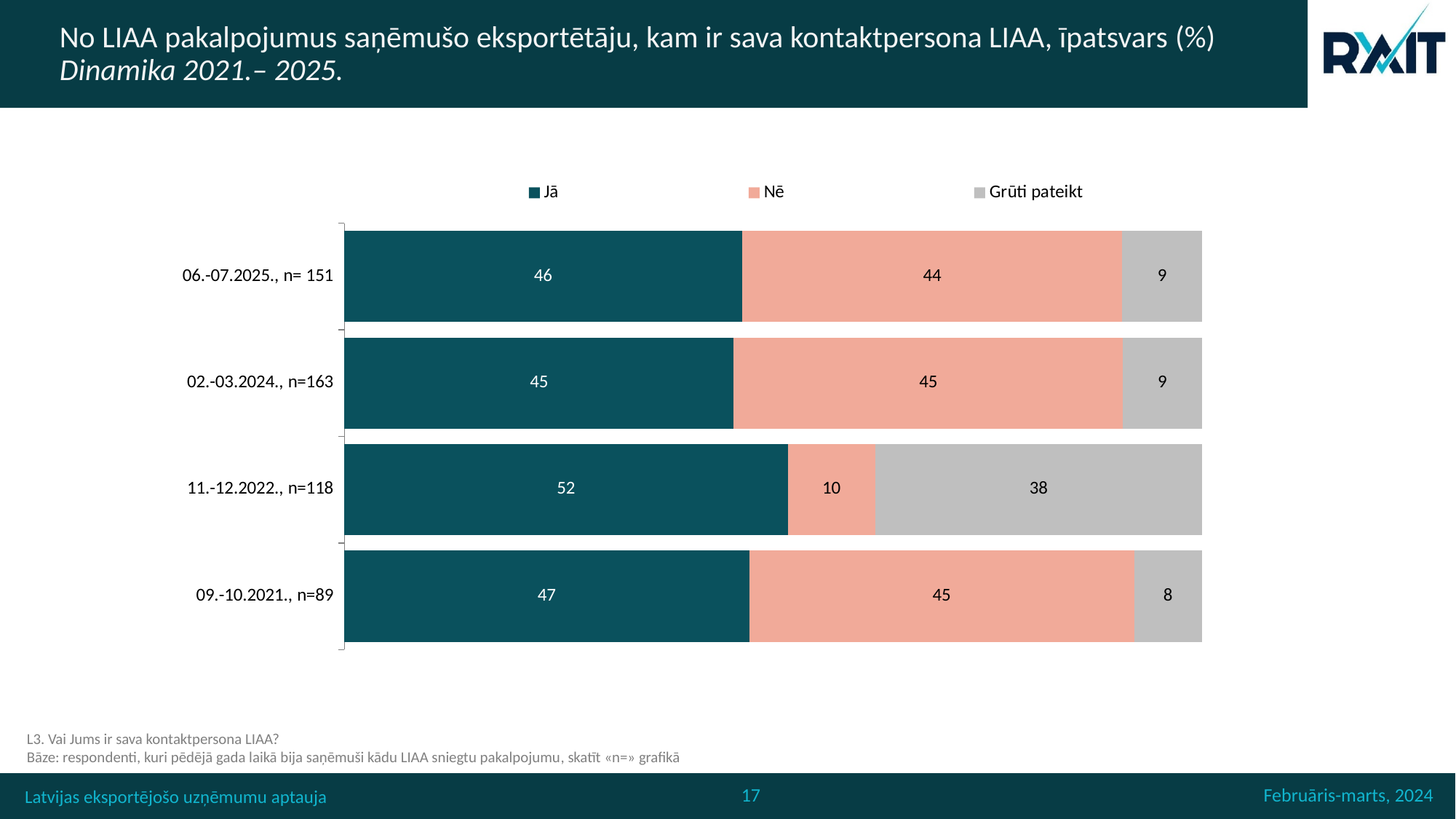
What kind of chart is shown on the slide? Stacked bar chart What is the value for "Nē" in the 11.-12.2022., n=118 bar? 10 What is the value for "Grūti pateikt" in the 09.-10.2021., n=89 bar? 8 Which period has the lowest value for "Nē"? 11.-12.2022., n=118 How many periods (bars) are shown in the chart? 4 Which is larger: the "Jā" value for 09.-10.2021., n=89 or for 02.-03.2024., n=163? 09.-10.2021., n=89 How many series does the legend list? 3 Which legend entry is shown in grey? Grūti pateikt What is the difference between the "Grūti pateikt" value for 11.-12.2022., n=118 and for 02.-03.2024., n=163? 29 Which period has the highest value for "Jā"? 11.-12.2022., n=118 What is the value for "Jā" in the 06.-07.2025., n= 151 bar? 46 What is the total of the 11.-12.2022., n=118 bar? 100